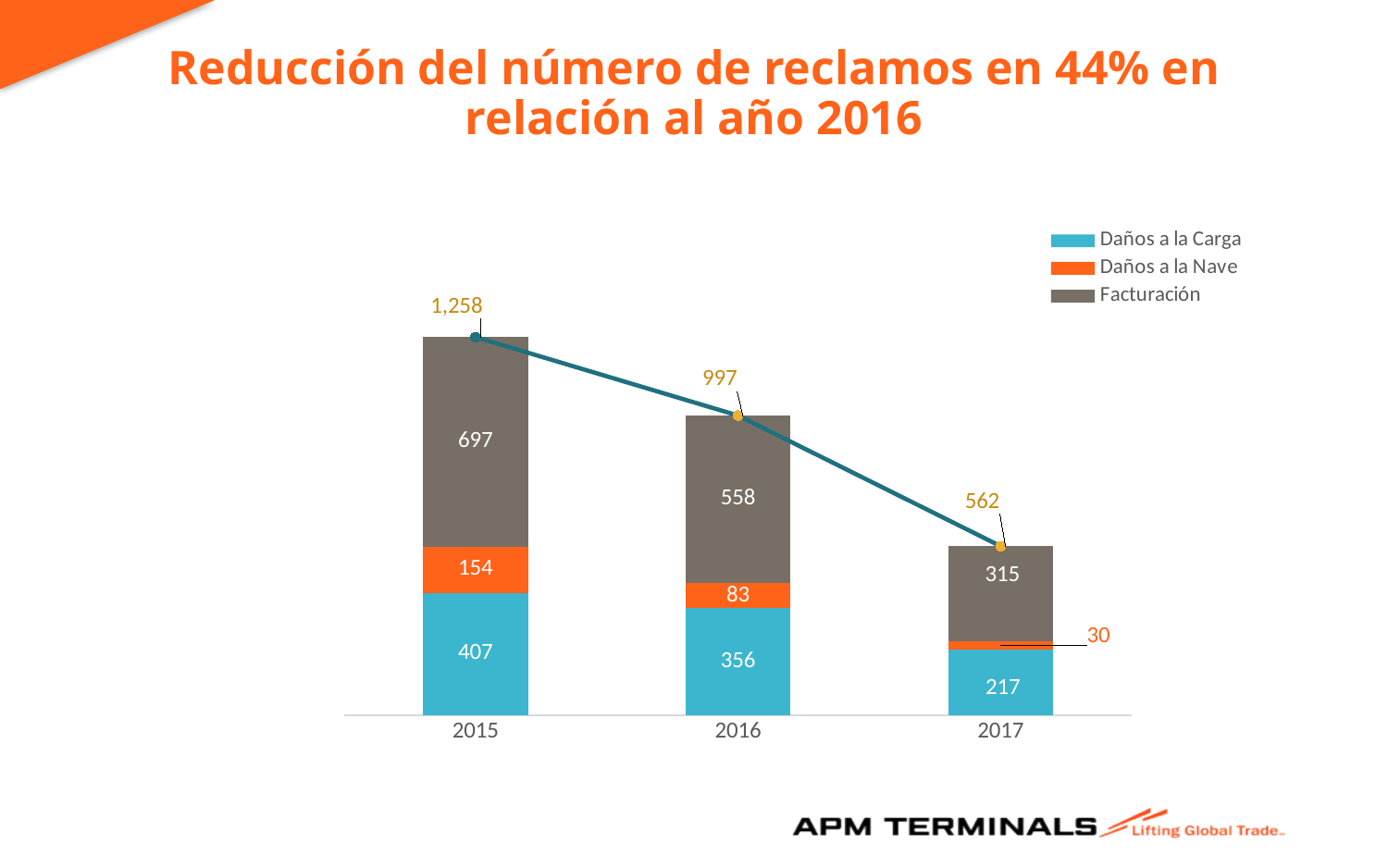
Is the Daños a la Carga value larger in 2015 or in 2017? 2015 What is the difference between the Facturación values for 2015 and 2017? 382 What is the total of the stacked bar for 2016? 997 What is the Daños a la Nave value for 2017? 30 What is the total of the stacked bar for 2015? 1,258 What is the Facturación value for 2015? 697 How many series does the legend list? 3 Which year has the lowest total? 2017 What is the Daños a la Carga value for 2016? 356 How many years are shown on the x axis? 3 Which year has the highest Daños a la Nave value? 2015 Do the totals rise or fall from 2015 to 2017? fall